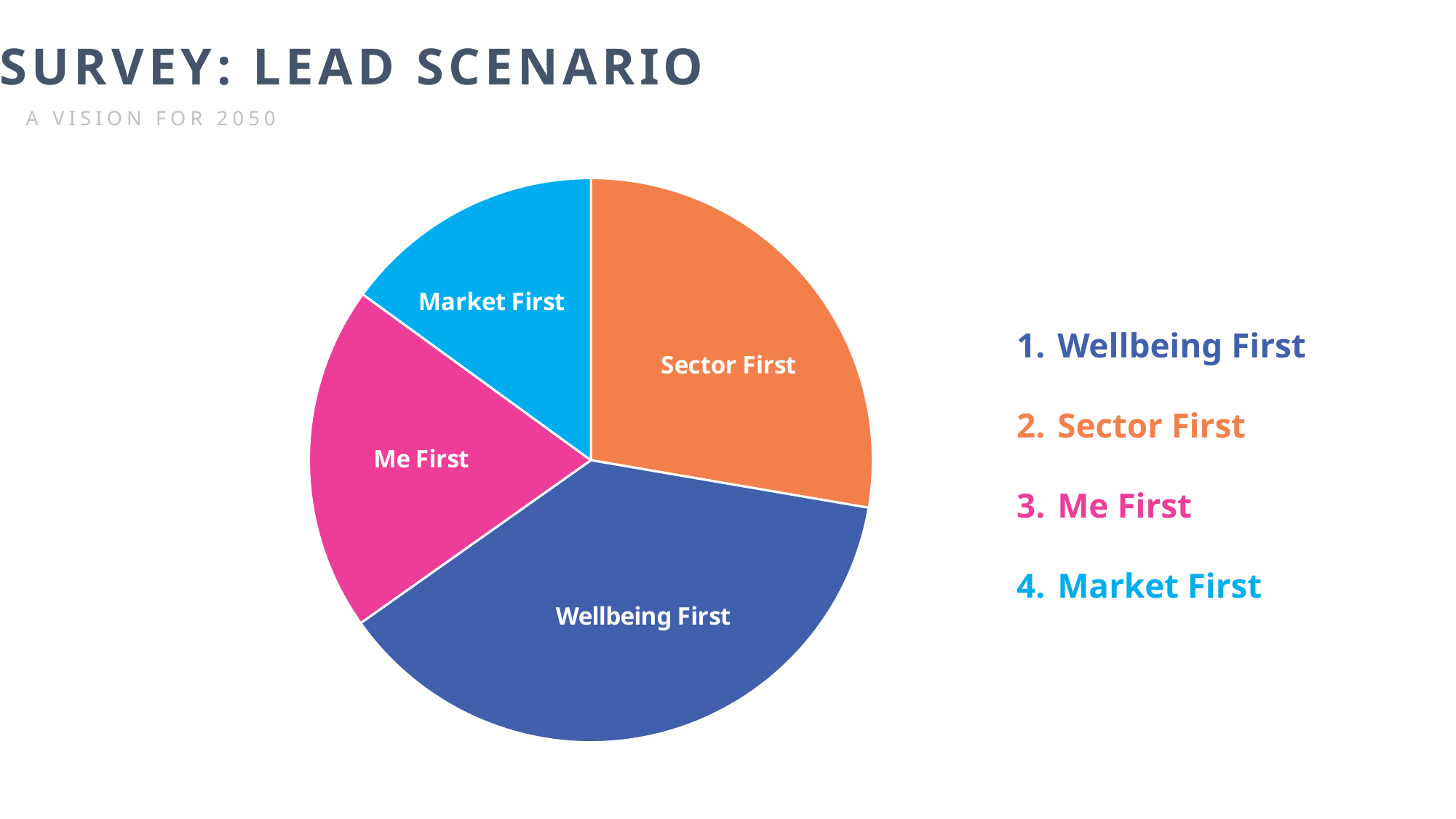
What kind of chart is shown on the slide? pie chart Which scenario has the largest slice of the pie chart? Wellbeing First Which scenario has the smallest slice of the pie chart? Market First Which slice is larger, Sector First or Me First? Sector First Which slice is larger, Me First or Market First? Me First How many slices does the pie chart have? 4 Which slice is larger, Wellbeing First or Sector First? Wellbeing First What is the title of the slide containing the pie chart? SURVEY: LEAD SCENARIO What colour is the Me First slice of the pie chart? pink